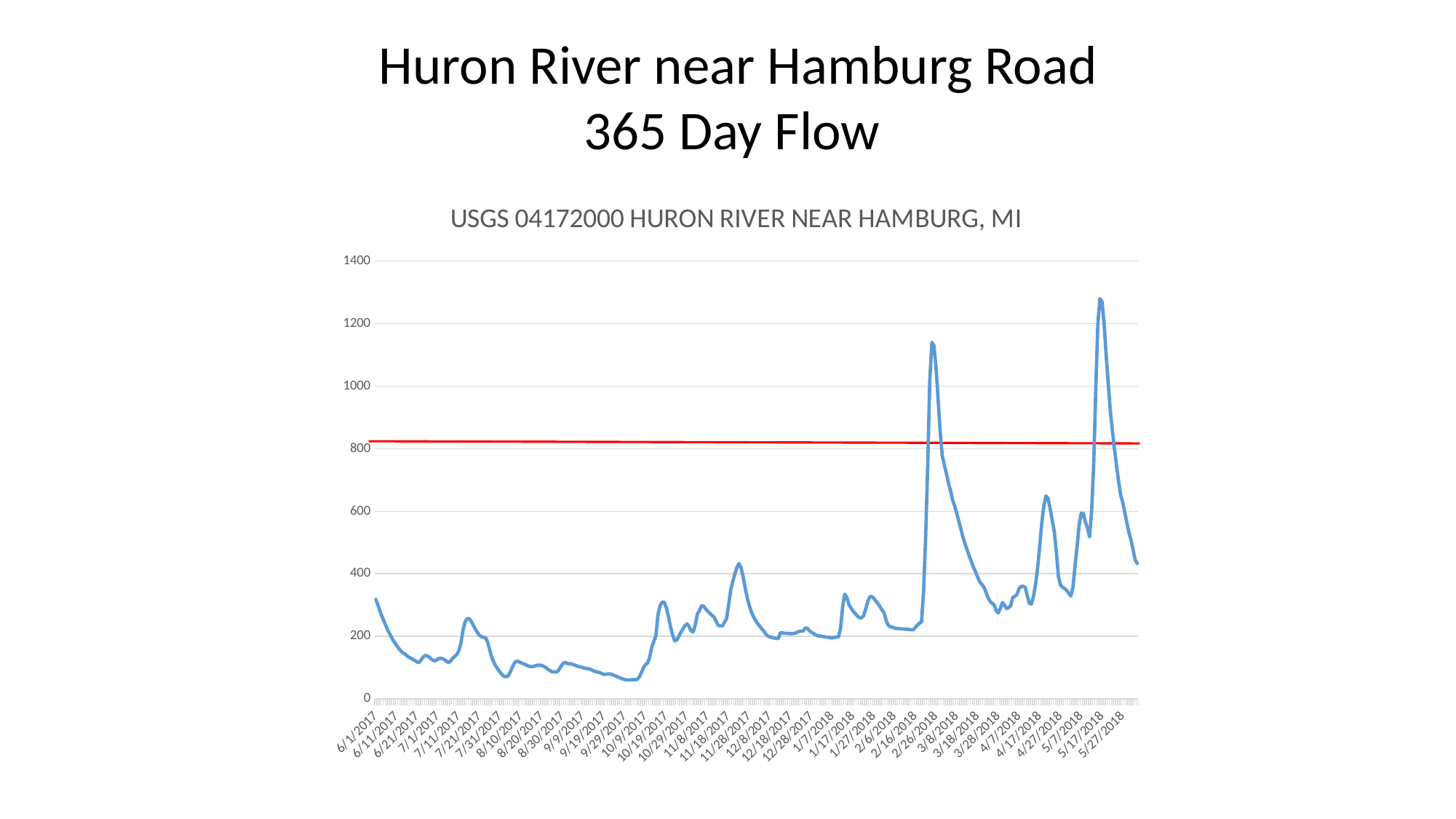
Which peak is larger: the one near 2/26/2018 or the one near 5/17/2018? 5/17/2018 What is the title printed above the chart's plot area? USGS 04172000 HURON RIVER NEAR HAMBURG, MI Around which x-axis date does the blue flow line reach its highest value? 5/17/2018 Is the flow value around 9/29/2017 greater or less than 200? less What colour is the nearly flat horizontal reference line drawn across the chart? red What kind of chart is shown on the slide? line chart Do the flow values generally rise or fall between 6/1/2017 and 9/29/2017? fall Which peak is larger: the one near 11/18/2017 or the one near 4/17/2018? 4/17/2018 Is the highest peak of the blue flow line, near 5/17/2018, greater or less than 1200? greater Is the flow value at 6/1/2017 greater or less than 400? less